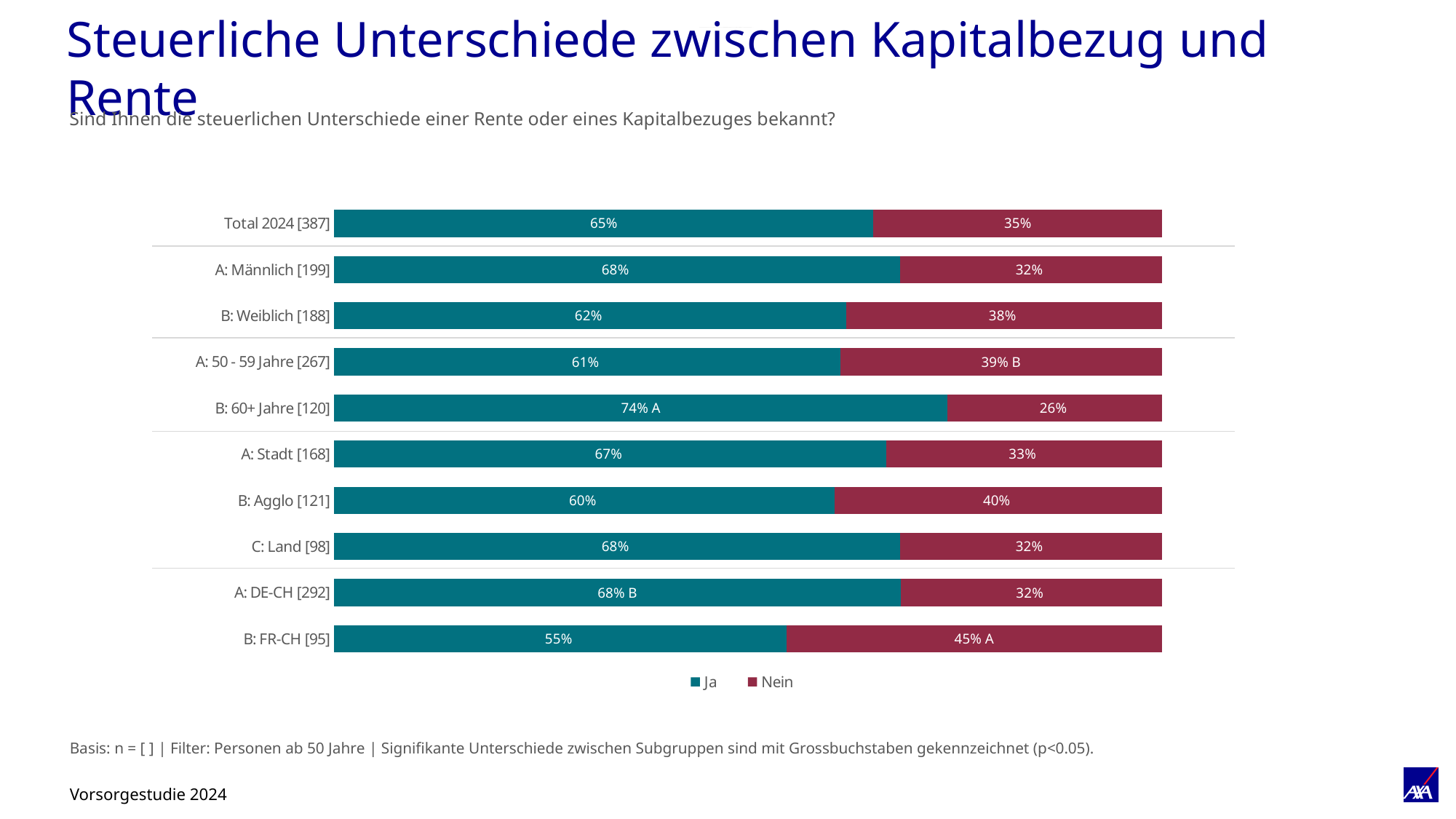
What is the difference between the 'Ja' values for A: Männlich [199] and B: Weiblich [188]? 6 percentage points Which has a larger 'Nein' value, A: Stadt [168] or B: Agglo [121]? B: Agglo [121] Which category has the highest 'Ja' value? B: 60+ Jahre [120] Which category has the lowest 'Ja' value? B: FR-CH [95] What kind of chart is shown on the slide? Stacked bar chart What is the total of the stacked bar for A: 50 - 59 Jahre [267]? 100% What is the 'Ja' value for B: 60+ Jahre [120]? 74% What is the 'Ja' value for Total 2024 [387]? 65% What is the 'Nein' value for B: FR-CH [95]? 45% How many series does the legend list? 2 What are the two legend entries of the chart? Ja and Nein How many categories are shown on the chart? 10